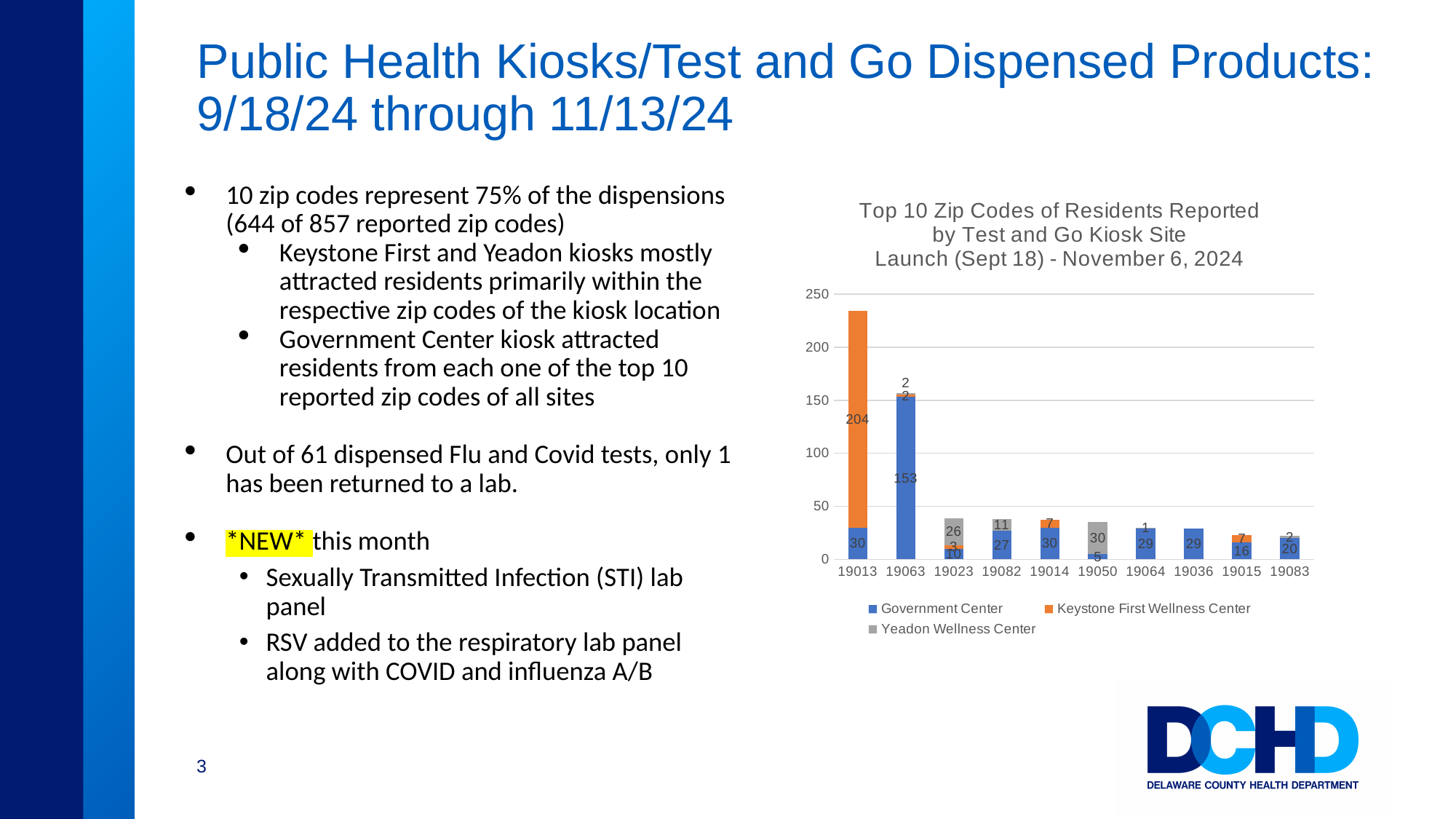
What is the Keystone First Wellness Center value for zip code 19013? 204 Is the total stacked bar for zip code 19013 greater or less than 200? greater Which is larger: the Yeadon Wellness Center value for 19023 or for 19050? 19050 What is the total of the stacked bar for zip code 19013? 234 What is the Yeadon Wellness Center value for zip code 19082? 11 How many zip codes are shown on the x axis of the chart? 10 What is the Government Center value for zip code 19063? 153 For zip code 19013, how much larger is the Keystone First Wellness Center value than the Government Center value? 174 Which zip code has the highest Government Center value? 19063 What kind of chart is shown on the slide? Stacked bar chart How many series does the chart legend list? 3 What colour represents Keystone First Wellness Center in the chart? Orange